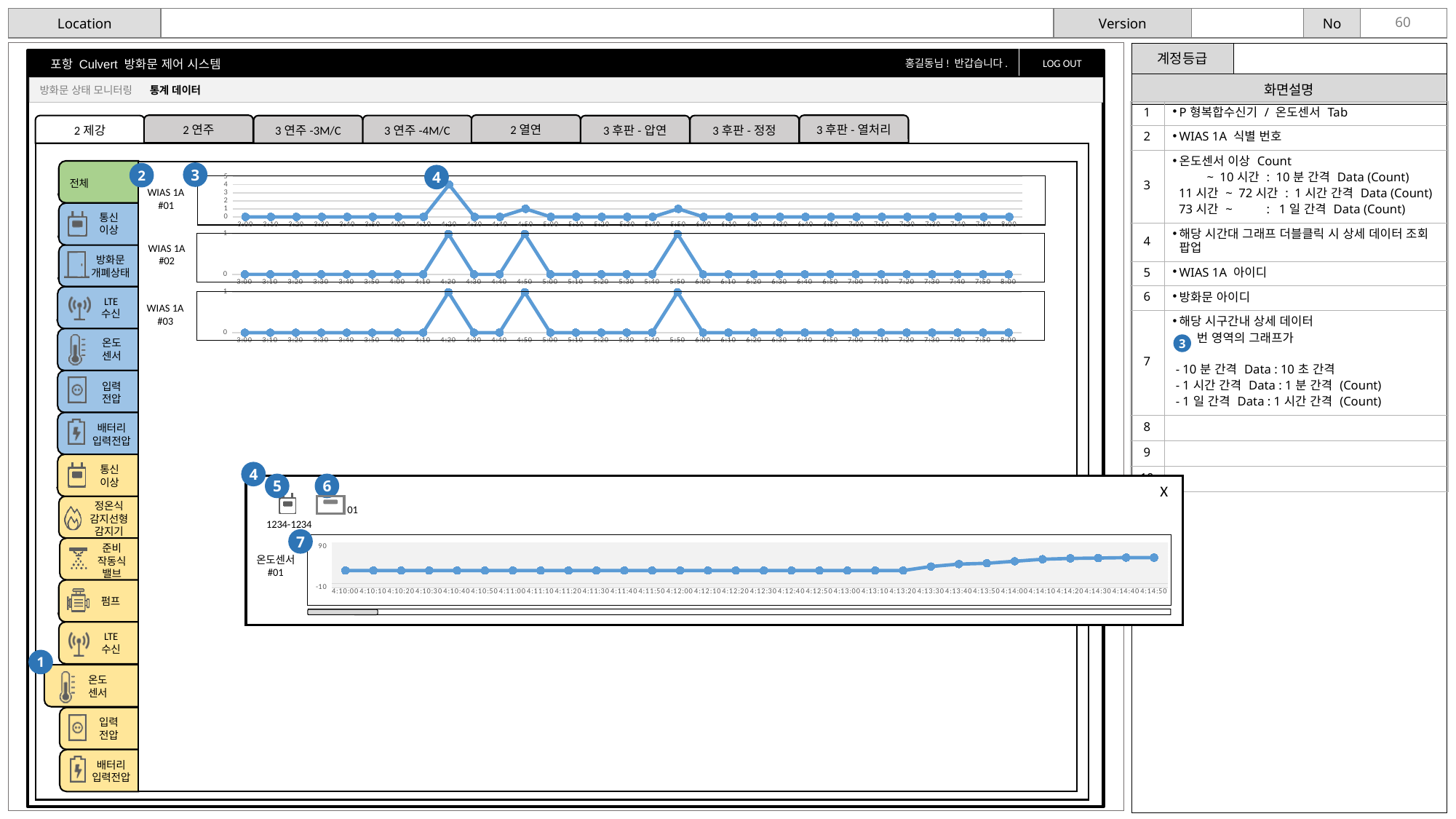
What kind of chart is used for WIAS 1A #02? line chart In the 온도센서 #01 chart in the popup, how does the line behave toward the right end of the x axis? it rises What time range does the x axis of the WIAS 1A #01 chart cover? 3:00 to 8:00 In the WIAS 1A #01 chart, which is larger, the value at 4:20 or the value at 4:50? 4:20 How many line charts are shown on the slide in total? 4 In the WIAS 1A #01 chart, at which time is the highest point? 4:20 In the WIAS 1A #02 chart, what is the value at 3:00? 0 In the WIAS 1A #02 chart, how many data points are plotted along the x axis from 3:00 to 8:00? 31 What is the highest y-axis tick shown on the 온도센서 #01 chart in the popup? 90 In the 온도센서 #01 chart in the popup, is the value at 4:10:00 greater or less than 90? less In the WIAS 1A #03 chart, at which three times does the line reach 1? 4:20, 4:50, 5:50 In the WIAS 1A #02 chart, what is the value at 4:20? 1